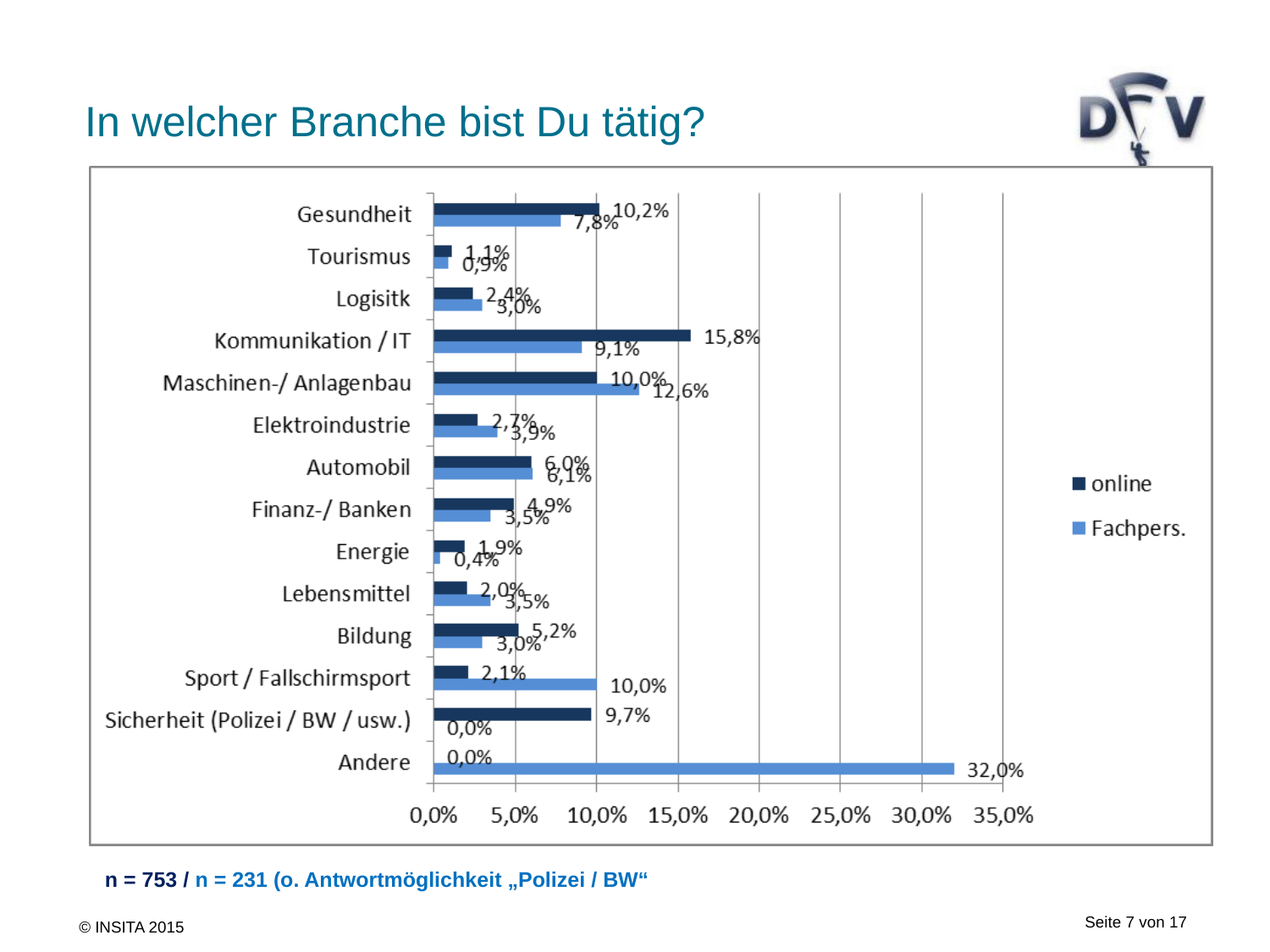
What is the difference between the online and Fachpers. values for Gesundheit? 2,4% Which category has the highest Fachpers. value? Andere What is the Fachpers. value for Sport / Fallschirmsport? 10,0% For Maschinen-/ Anlagenbau, which series has the larger value, online or Fachpers.? Fachpers. What is the Fachpers. value for Andere? 32,0% How many series does the legend list? 2 What is the online value for Sicherheit (Polizei / BW / usw.)? 9,7% How many industry categories are shown on the chart? 14 What is the title of the chart on the slide? In welcher Branche bist Du tätig? Which category has the highest online value? Kommunikation / IT What is the online value for Kommunikation / IT? 15,8% What type of chart is shown on the slide? bar chart